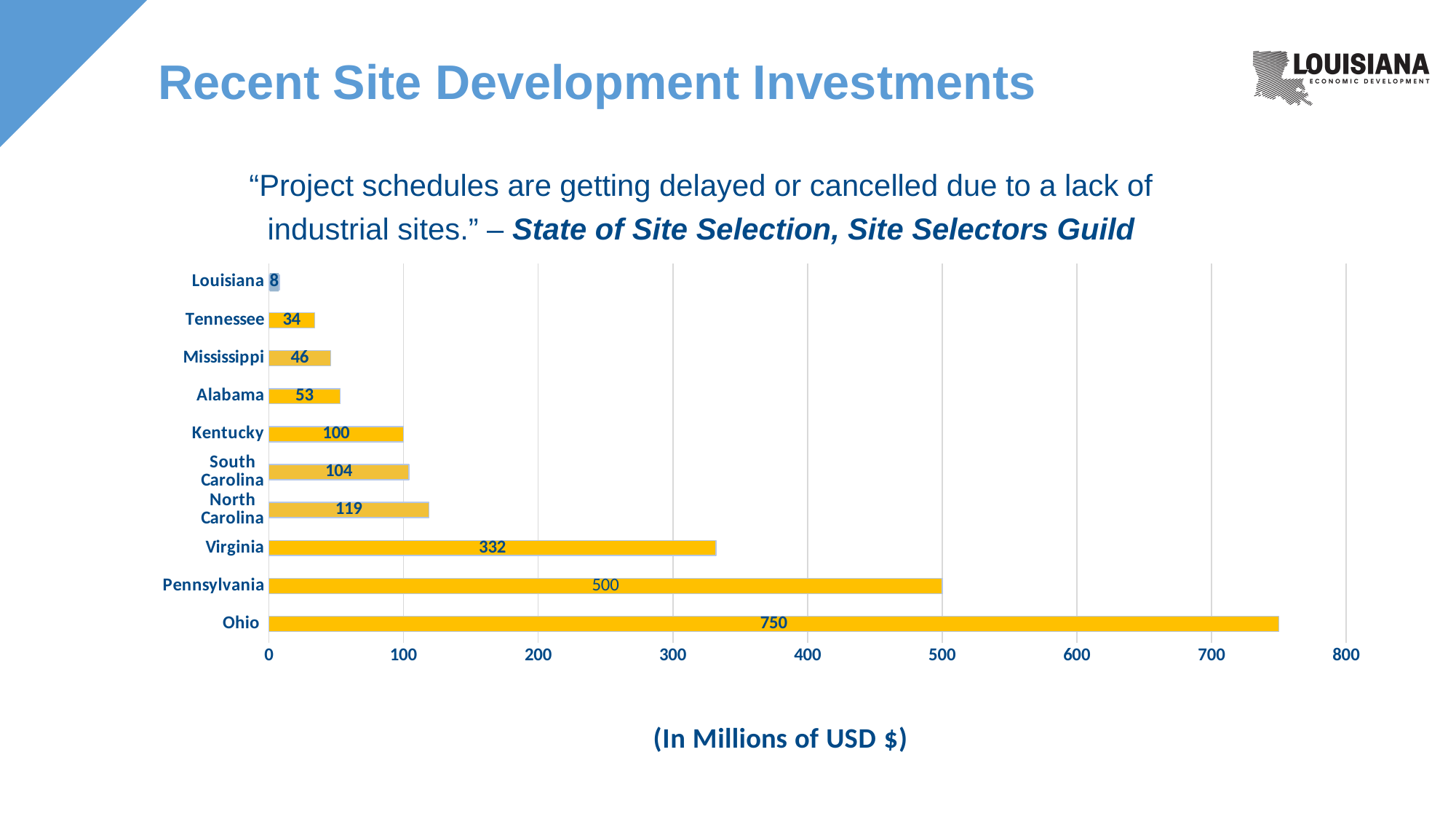
Which state's bar is coloured differently from the others? Louisiana What is the value for Louisiana? 8 Is the value for Virginia greater or less than 300? greater What is the difference between the values for Pennsylvania and Virginia? 168 Which state has the highest value? Ohio Which state has the lowest value? Louisiana Which is larger, the value for Kentucky or the value for Alabama? Kentucky How many states are shown in the chart? 10 What is the value for Ohio? 750 What unit is the chart's data expressed in, according to the caption below the chart? In Millions of USD $ What kind of chart is shown on the slide? bar chart What is the value for North Carolina? 119